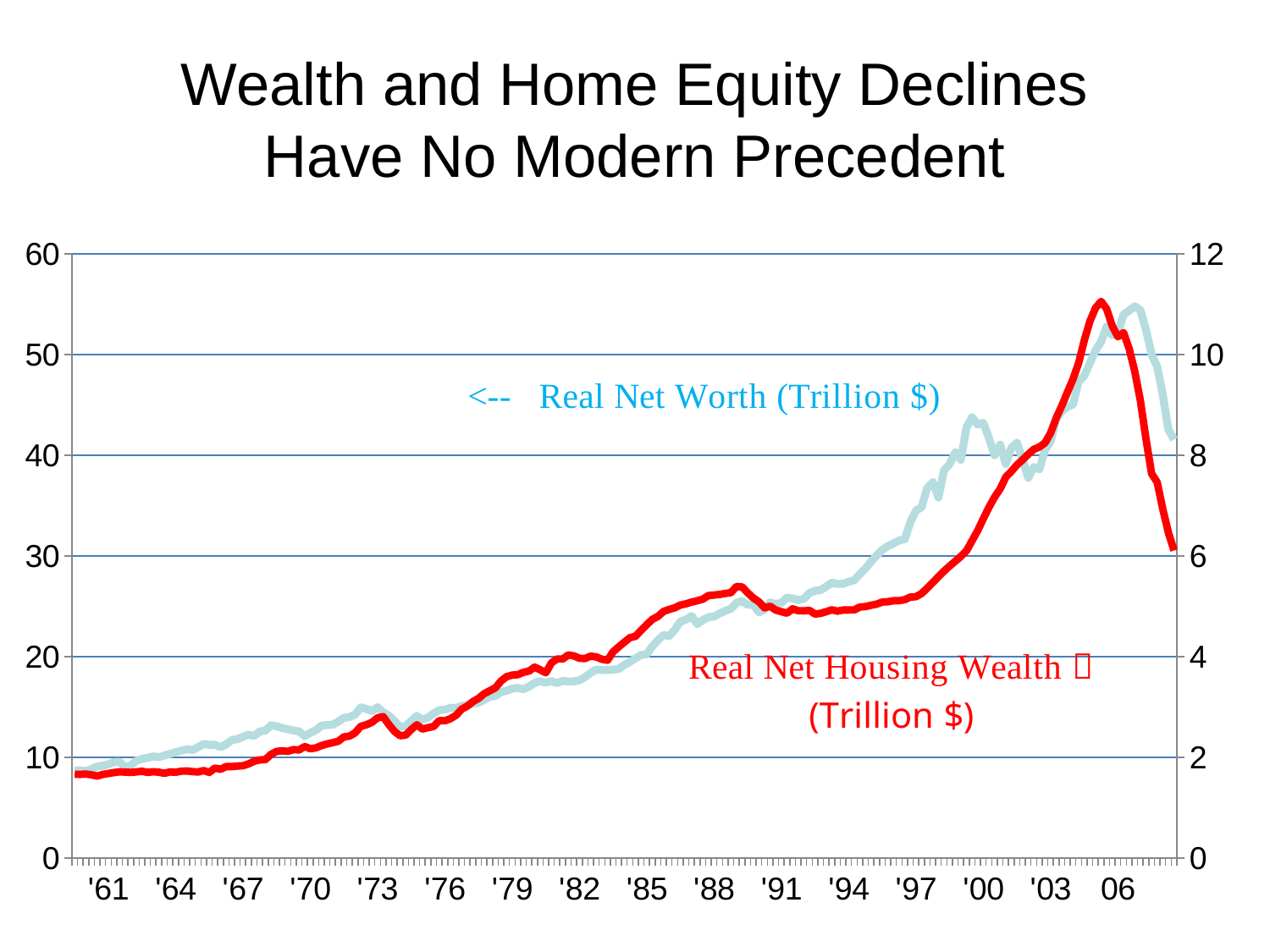
Is the value of Real Net Housing Wealth in '91 greater or less than 6 on the right axis? less Which colour is the Real Net Housing Wealth line drawn in? red Is the value of Real Net Housing Wealth in '73 greater or less than 4 on the right axis? less Does Real Net Worth generally rise or fall from '61 to '06? rise Is the peak value of Real Net Worth around '07 greater or less than 50 on the left axis? greater After its peak around '05, does Real Net Housing Wealth rise or fall toward the end of the chart? fall What is the title of the slide's chart? Wealth and Home Equity Declines Have No Modern Precedent What kind of chart is shown on the slide? line chart How many data series are plotted on the chart? 2